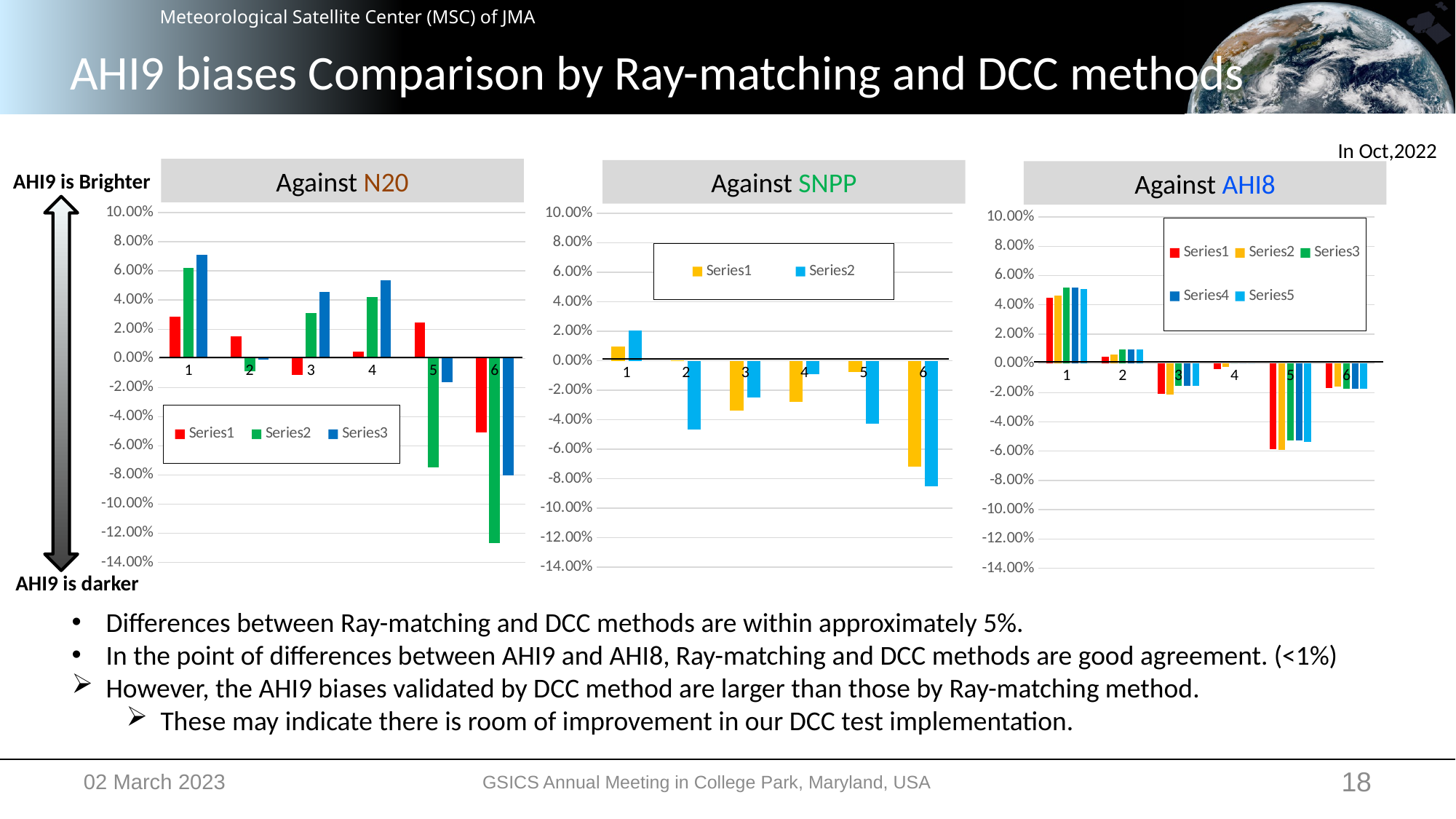
In the "Against AHI8" chart, is the Series1 value for category 5 greater or less than -4.00%? less In the "Against N20" chart, which category has the lowest Series2 value? 6 How many series does the legend of the "Against AHI8" chart list? 5 In the "Against N20" chart, is the Series3 value for category 1 greater or less than 6.00%? greater In the "Against N20" chart, is the Series2 value for category 6 greater or less than -10.00%? less What kind of chart is the "Against N20" chart? bar chart In the "Against N20" chart, which is larger for category 1: Series2 or Series3? Series3 How many series does the legend of the "Against SNPP" chart list? 2 How many categories are shown on the x axis of the "Against N20" chart? 6 In the "Against SNPP" chart, which category has the lowest Series2 value? 6 In the "Against N20" chart, which category has the highest Series3 value? 1